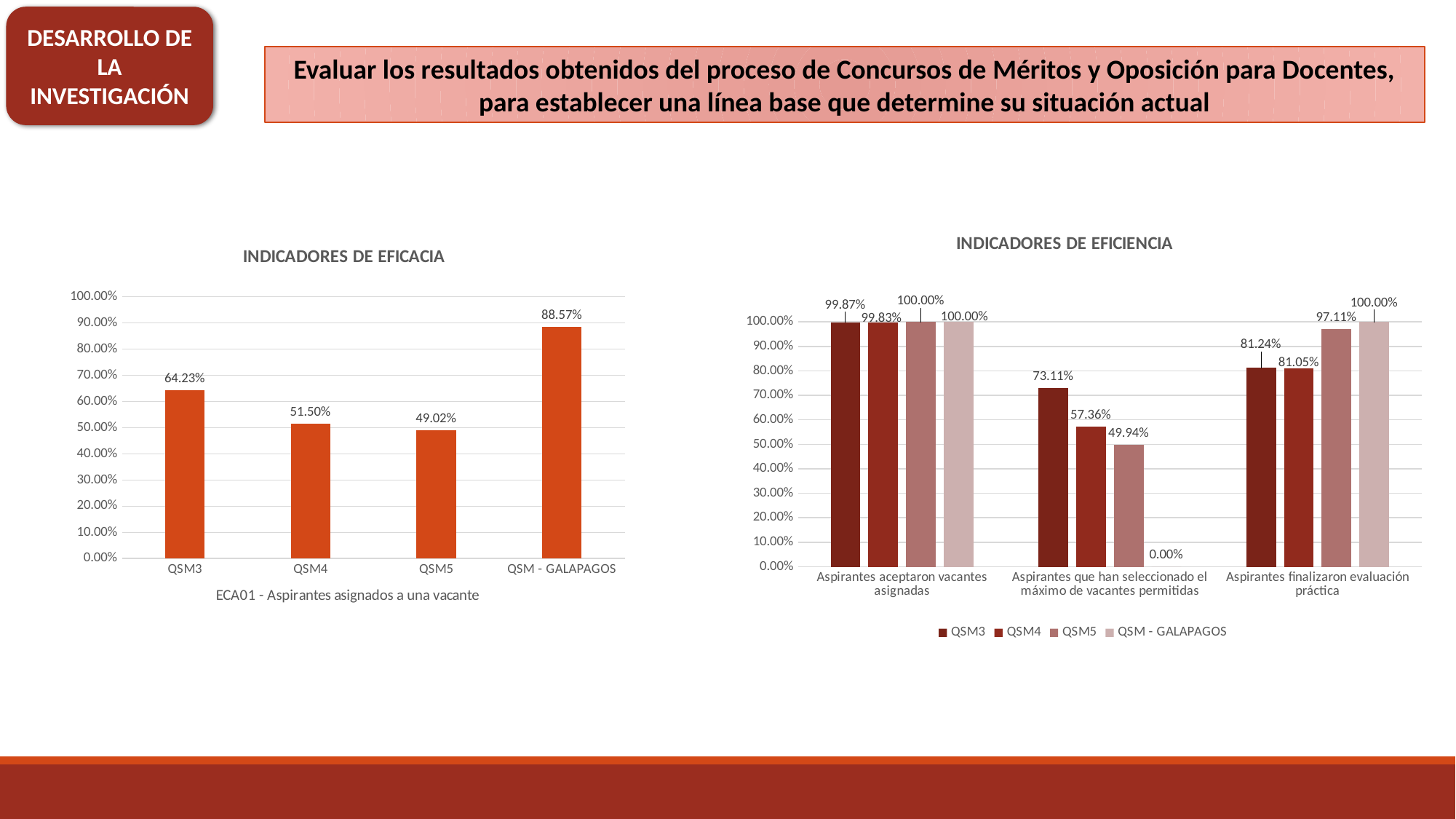
In the INDICADORES DE EFICIENCIA chart, what is the value for QSM5 in the category 'Aspirantes que han seleccionado el máximo de vacantes permitidas'? 49.94% In the INDICADORES DE EFICACIA chart, what is the difference between the values for QSM - GALAPAGOS and QSM3? 24.34% In the INDICADORES DE EFICACIA chart, how many categories are shown on the x axis? 4 In the INDICADORES DE EFICIENCIA chart, how many series does the legend list? 4 What kind of chart is the INDICADORES DE EFICACIA chart? Bar chart In the INDICADORES DE EFICIENCIA chart, what is the difference between QSM3 and QSM4 in the category 'Aspirantes que han seleccionado el máximo de vacantes permitidas'? 15.75% In the INDICADORES DE EFICACIA chart, which category has the highest value? QSM - GALAPAGOS In the INDICADORES DE EFICIENCIA chart, what is the value for QSM - GALAPAGOS in the category 'Aspirantes que han seleccionado el máximo de vacantes permitidas'? 0.00% In the INDICADORES DE EFICACIA chart, what is the value for QSM4? 51.50% In the INDICADORES DE EFICACIA chart, which category has the lowest value? QSM5 In the INDICADORES DE EFICIENCIA chart, which is larger for 'Aspirantes finalizaron evaluación práctica': QSM5 or QSM3? QSM5 What is the x-axis title of the INDICADORES DE EFICACIA chart? ECA01 - Aspirantes asignados a una vacante